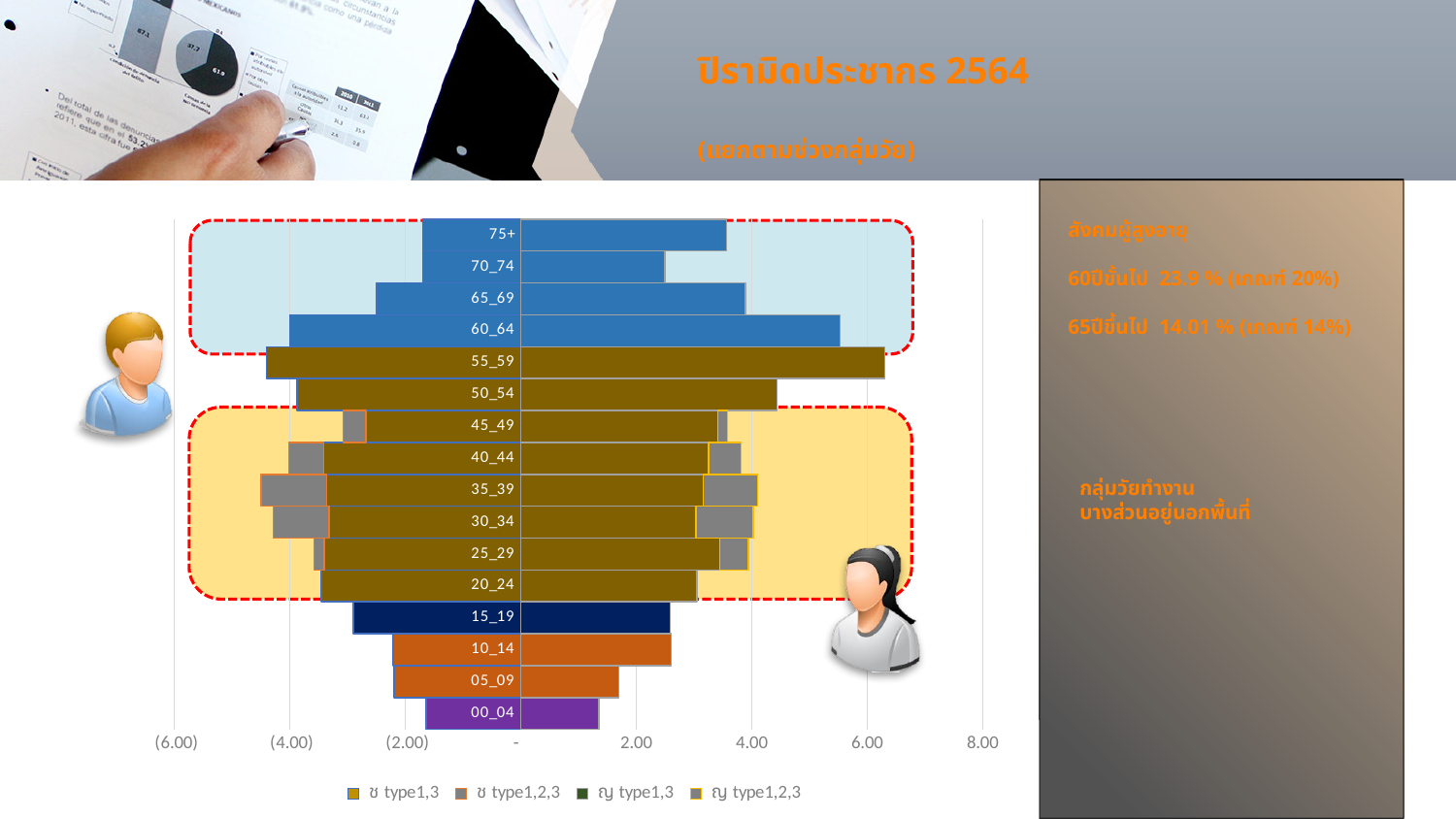
What kind of chart is shown on the slide? bar chart Which age group has the shortest bar on the right-hand side of the chart? 00_04 What is the title of the chart on the slide? ปีรามิดประชากร 2564 Is the right-hand bar for the 60_64 age group greater or less than 4.00? greater Is the right-hand bar for the 75+ age group greater or less than 4.00? less Which age group has the longest bar on the right-hand side of the chart? 55_59 Is the right-hand bar for the 55_59 age group greater or less than 6.00? greater On the right-hand side of the chart, which bar is longer: 75+ or 70_74? 75+ On the right-hand side of the chart, which bar is longer: 60_64 or 65_69? 60_64 How many age-group categories are shown on the chart? 16 How many series does the chart legend list? 4